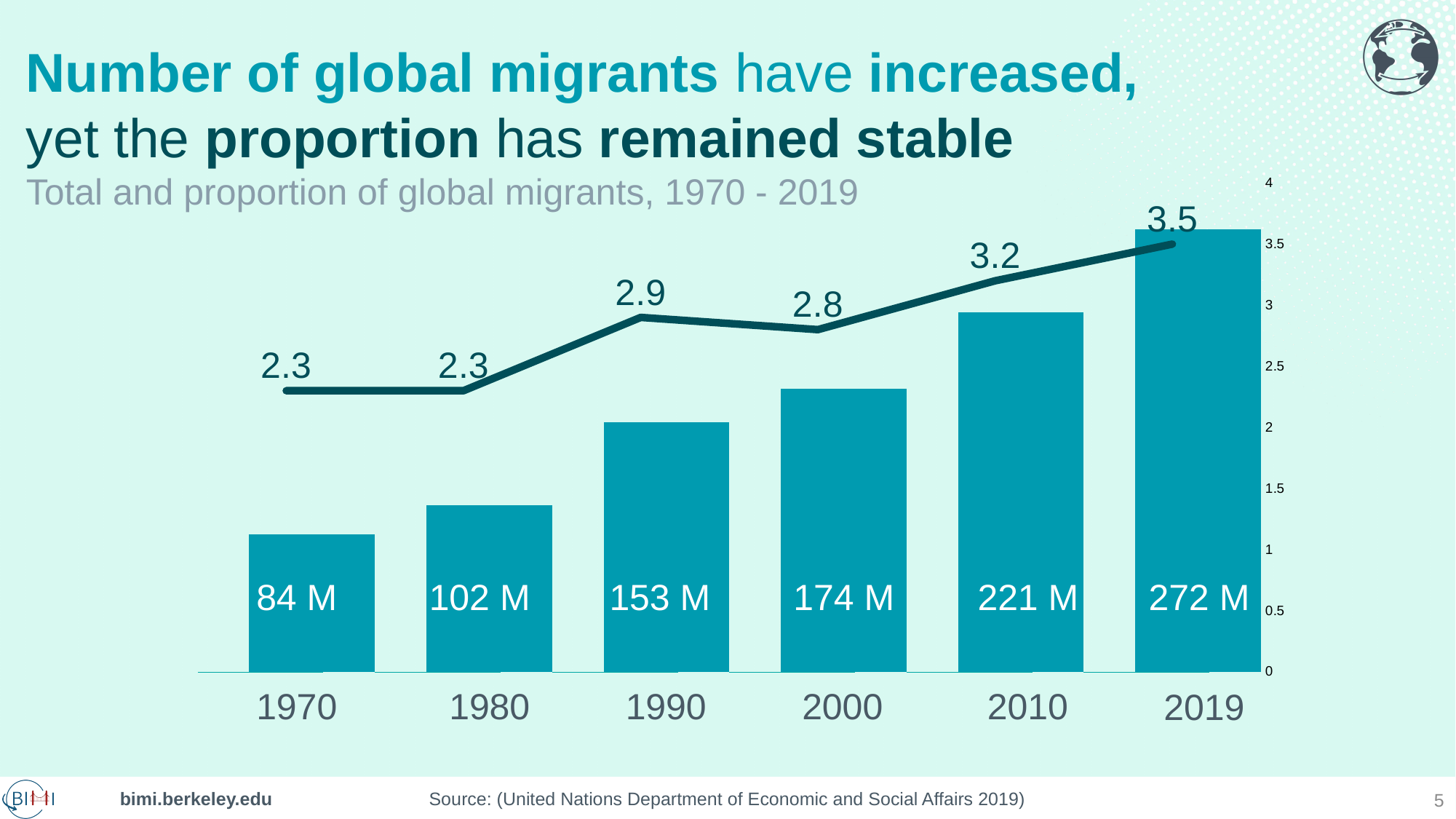
What is the difference between the proportion values for 2019 and 1970? 1.2 What proportion value does the line show for 2010? 3.2 What is the total number of global migrants shown for 2019? 272 M Which year has the larger proportion value, 1990 or 2000? 1990 What proportion value does the line show for 1990? 2.9 What is the subtitle of the chart below the main heading? Total and proportion of global migrants, 1970 - 2019 What is the total number of global migrants shown for 1970? 84 M How many years are shown on the x axis of the chart? 6 Which year has the highest total number of global migrants? 2019 Which year has the lowest total number of global migrants? 1970 What is the difference in the number of global migrants between 2019 and 1970? 188 M Do the bar values rise or fall from 1970 to 2019? rise